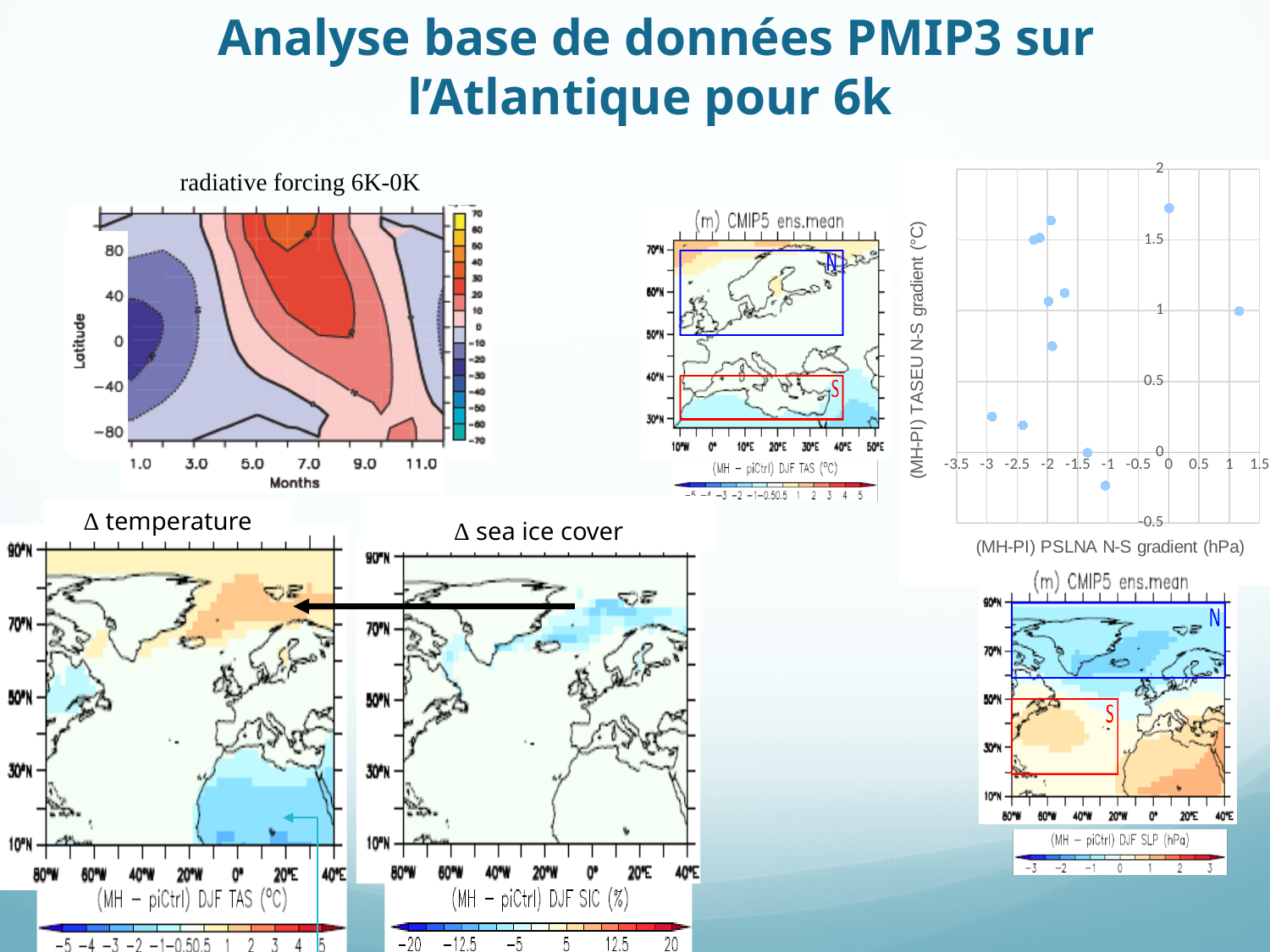
In the 'radiative forcing 6K-0K' contour plot, what is the label of the horizontal axis? Months In the scatter chart at the top right, is the horizontal-axis value of the leftmost point greater or less than -2.5? less In the 'radiative forcing 6K-0K' contour plot, what is the highest value on the colour scale? 70 In the scatter chart at the top right, what is the label of the vertical axis? (MH-PI) TASEU N-S gradient (°C) What is the title of the contour plot at the top left of the slide? radiative forcing 6K-0K In the scatter chart at the top right, what is the maximum value shown on the vertical axis? 2 In the scatter chart at the top right, is the vertical-axis value of the lowest point (near x = -1) greater or less than 0? less In the scatter chart at the top right, what is the minimum value shown on the horizontal axis? -3.5 What kind of chart is the one in the top right with axes labelled '(MH-PI) PSLNA N-S gradient (hPa)' and '(MH-PI) TASEU N-S gradient (°C)'? scatter chart In the scatter chart at the top right, is the vertical-axis value of the point near x = 0 greater or less than 1.5? greater